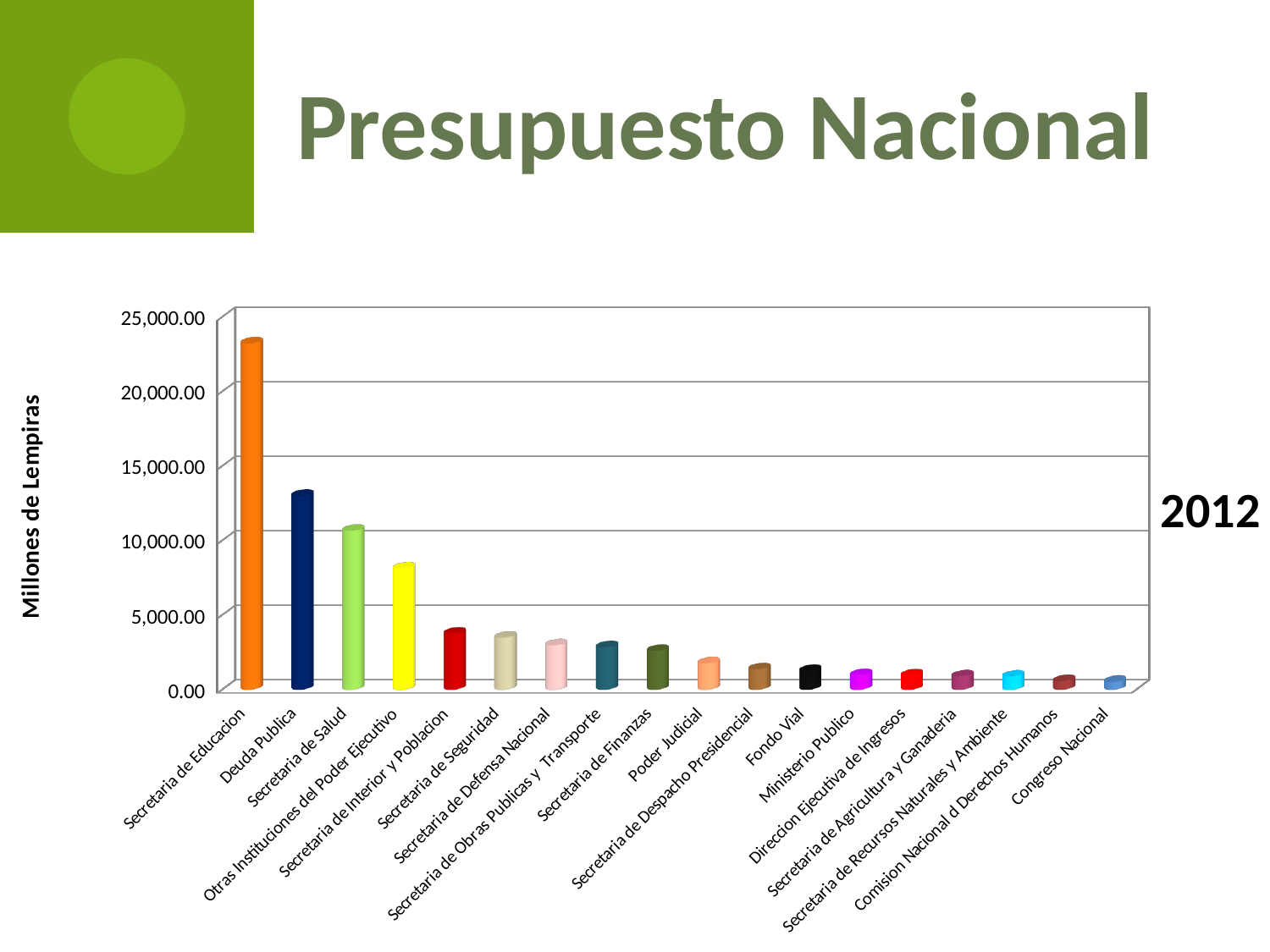
Do the values rise or fall moving from left to right along the x axis? Fall Is the value for Secretaria de Educacion greater or less than 20,000.00? greater What kind of chart is shown on the slide? Bar chart Which category has the highest value in the chart? Secretaria de Educacion Is the value for Deuda Publica greater or less than 15,000.00? less What year is shown next to the chart? 2012 Is the value for Secretaria de Interior y Poblacion greater or less than 5,000.00? less What is the label on the vertical axis of the chart? Millones de Lempiras How many categories are plotted in the chart? 18 Which is larger, the value for Deuda Publica or the value for Secretaria de Salud? Deuda Publica